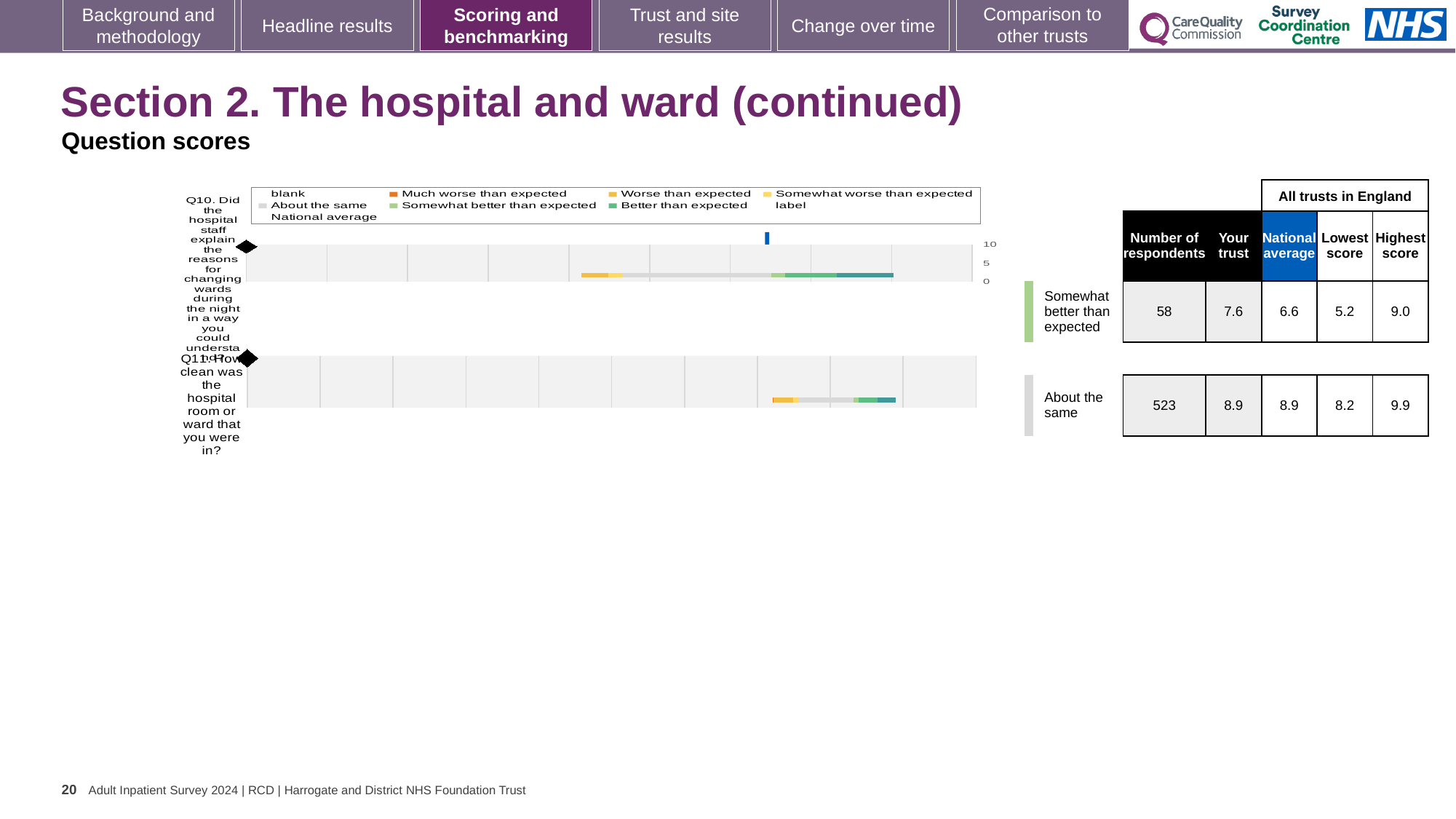
Which question has the higher 'Your trust' score, Q10 or Q11? Q11 What is the maximum value shown on the chart's score axis? 10 What is the national average score for Q10? 6.6 What is the 'Your trust' score for Q11 (how clean was the hospital room or ward)? 8.9 How many respondents answered Q11? 523 Which benchmark category does the trust's Q11 score fall into? About the same How many questions are plotted on the chart? 2 Which benchmark category does the trust's Q10 score fall into? Somewhat better than expected What kind of chart is used to show the question scores for Q10 and Q11? Bar chart By how much does the trust's Q10 score exceed the national average for Q10? 1.0 What is the 'Your trust' score for Q10 (explaining reasons for changing wards during the night)? 7.6 What is the difference between the highest and lowest trust scores in England for Q10? 3.8